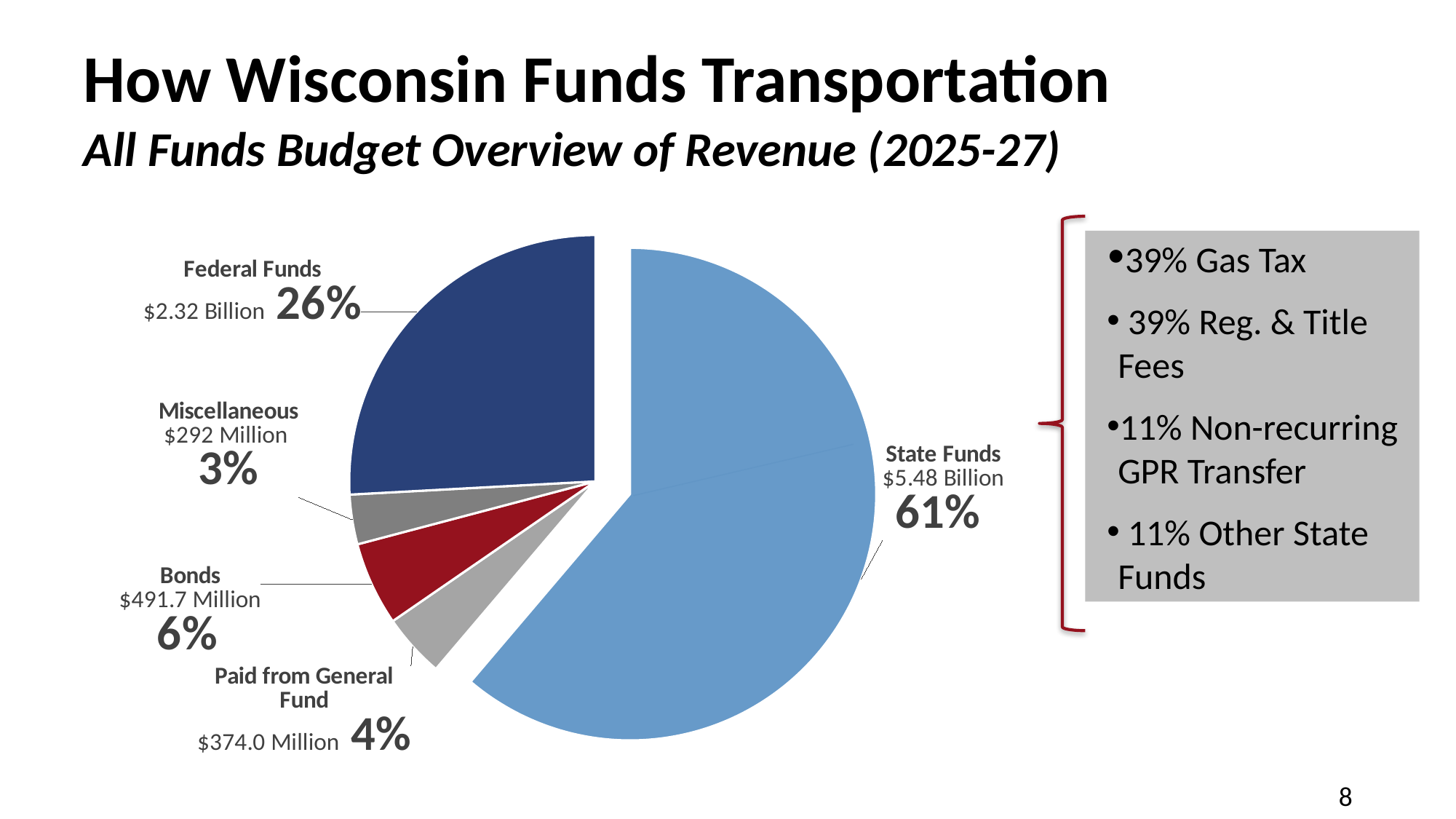
Which category has the largest slice of the pie? State Funds Which is larger, the share for Bonds or the share for Paid from General Fund? Bonds What percentage of the pie is Paid from General Fund? 4% What share of the pie does State Funds represent? 61% How many slices does the pie chart have? 5 What is the difference in percentage points between the State Funds share and the Federal Funds share? 35 Which category has the smallest slice of the pie? Miscellaneous What colour is the State Funds slice? Light blue What is the dollar value shown for Federal Funds? $2.32 Billion What is the dollar value shown for Miscellaneous? $292 Million What kind of chart is shown on the slide? Pie chart What is the dollar value shown for Bonds? $491.7 Million